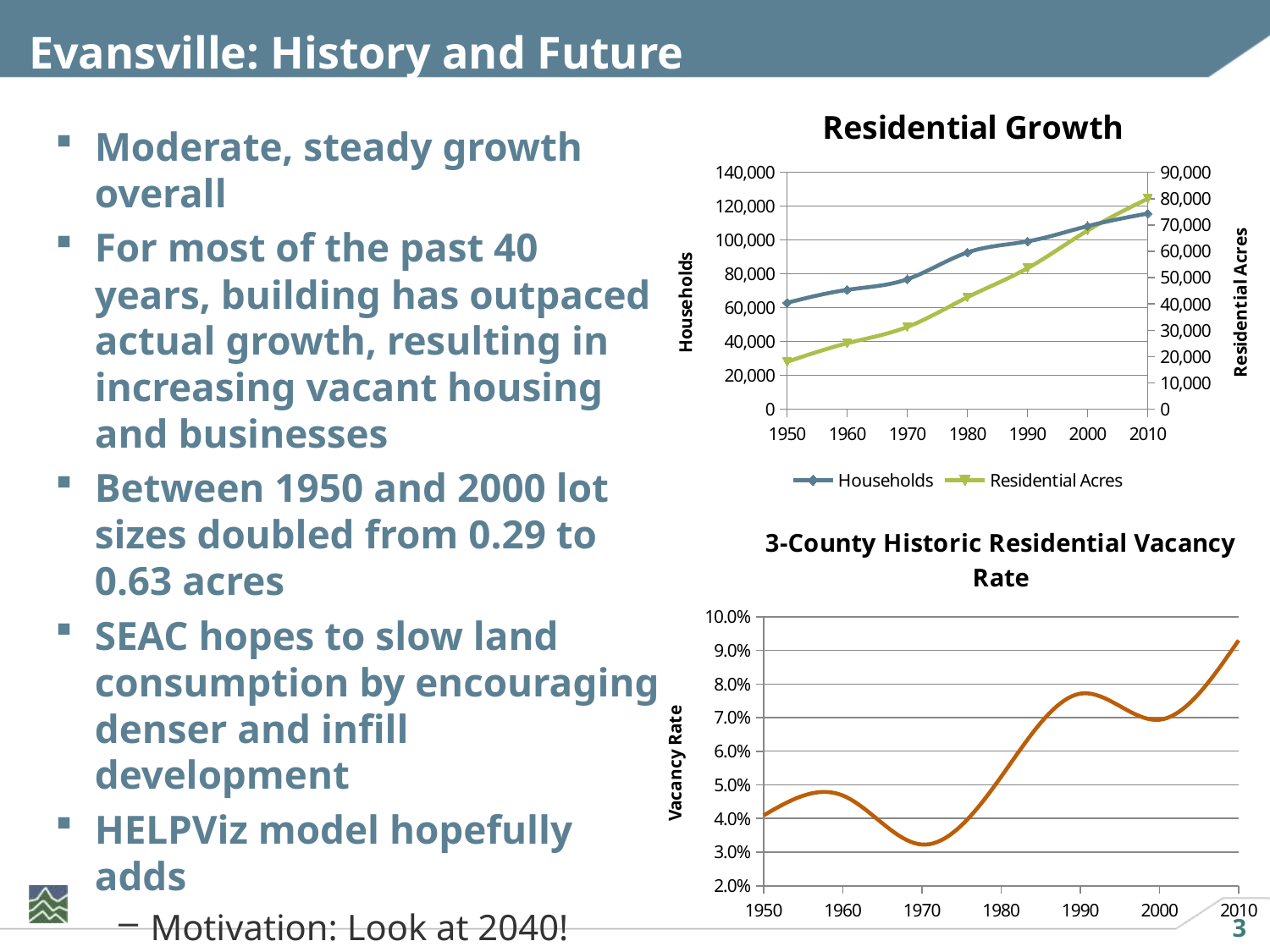
In the "3-County Historic Residential Vacancy Rate" chart, which year has the lowest vacancy rate? 1970 In the "Residential Growth" chart, is the Residential Acres value for 2010 greater or less than 70,000? greater In the "Residential Growth" chart, do the Households values rise or fall from 1950 to 2010? rise In the "Residential Growth" chart, what is the label of the right-hand vertical axis? Residential Acres In the "Residential Growth" chart, is the Households value for 2010 greater or less than 100,000? greater In the "Residential Growth" chart, how many years are marked on the x axis? 7 In the "Residential Growth" chart, is the Households value for 1950 greater or less than 80,000? less What kind of chart is the "Residential Growth" chart? line chart In the "3-County Historic Residential Vacancy Rate" chart, is the vacancy rate higher in 1990 or in 2000? 1990 How many series does the legend of the "Residential Growth" chart list? 2 In the "3-County Historic Residential Vacancy Rate" chart, which year has the highest vacancy rate? 2010